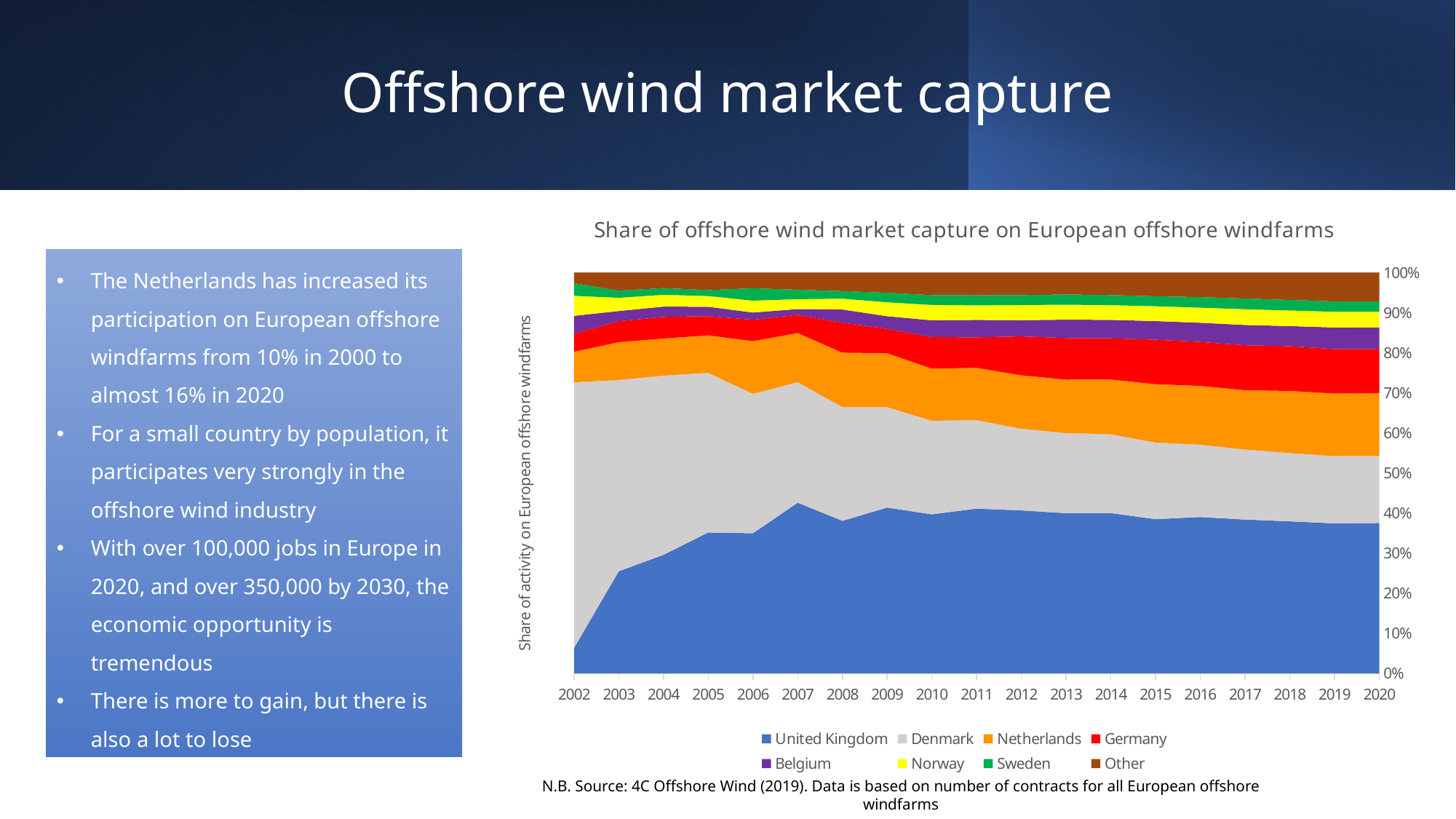
Does the United Kingdom's share rise or fall from 2002 to 2020? rise What is the title of the chart? Share of offshore wind market capture on European offshore windfarms Which country has the largest share of activity in 2020? United Kingdom Is the United Kingdom's share in 2003 greater or less than 20%? greater How many years are shown along the x axis of the chart? 19 Which country has the largest share of activity in 2002? Denmark How many series does the chart legend list? 8 What kind of chart is shown on the slide? Stacked area chart Is the United Kingdom's share in 2020 greater or less than 30%? greater What is the first year shown on the x axis? 2002 Is the United Kingdom's share in 2002 greater or less than 10%? less What is the last year shown on the x axis? 2020